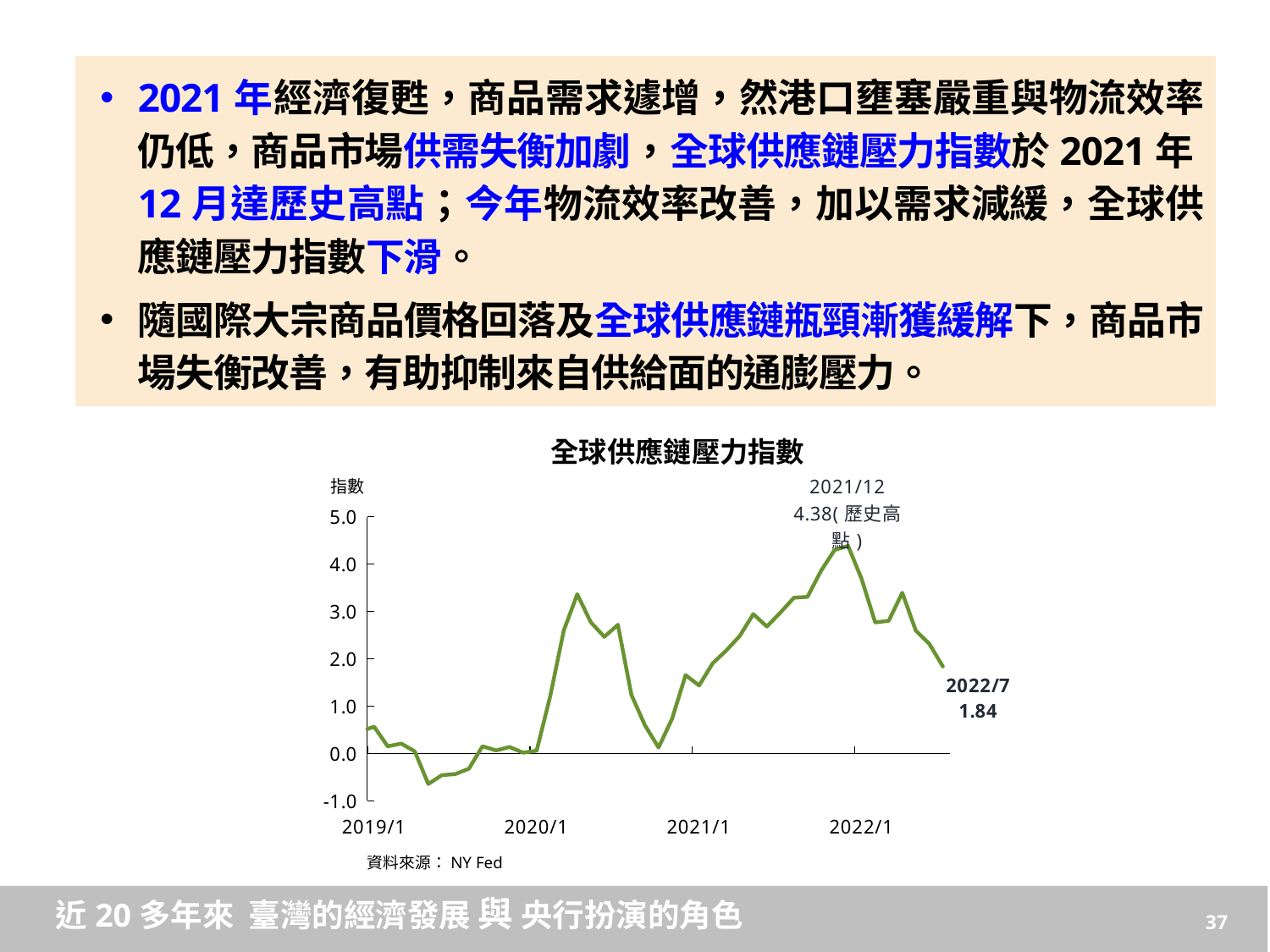
Which is larger, the index value at 2021/12 or at 2022/7? 2021/12 What is the value of the 全球供應鏈壓力指數 at 2022/7? 1.84 Is the index value at 2021/1 greater or less than 1.0? greater Which month is labelled as the historical high (歷史高點) of the index? 2021/12 Does the index rise or fall between 2021/12 and 2022/7? Fall What is the title of the chart? 全球供應鏈壓力指數 How many year labels are shown on the x axis of the chart? 4 What is the data source given for the chart? NY Fed What is the difference between the index value at 2021/12 and at 2022/7? 2.54 Is the index value at 2020/1 greater or less than 1.0? less What kind of chart is used to show the 全球供應鏈壓力指數? Line chart What is the value of the 全球供應鏈壓力指數 at 2021/12? 4.38